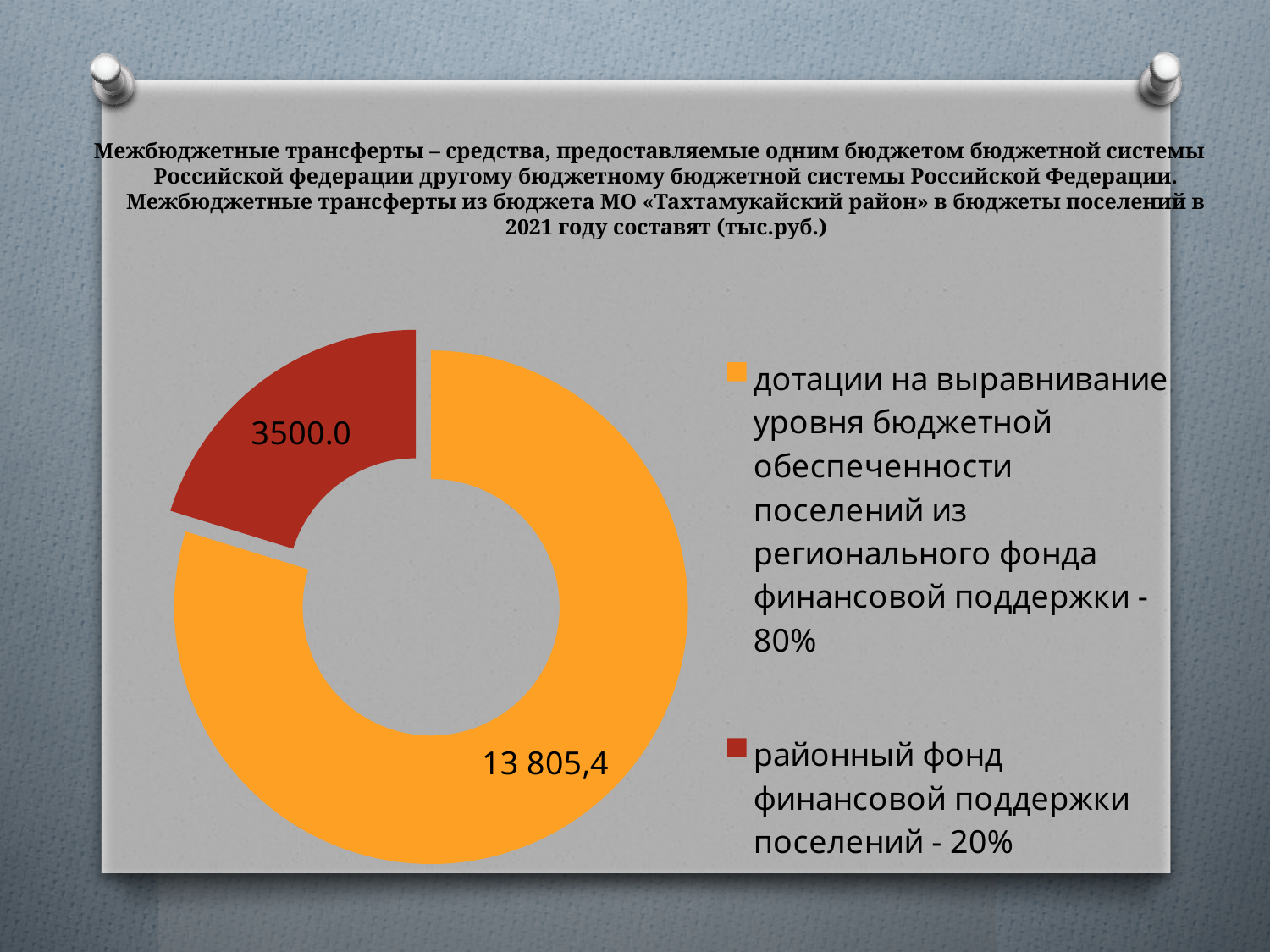
What is the value for 'районный фонд финансовой поддержки поселений'? 3500.0 What colour is the slice for 'дотации на выравнивание уровня бюджетной обеспеченности поселений'? orange What share of the chart does 'районный фонд финансовой поддержки поселений' represent? 20% What share of the chart does 'дотации на выравнивание уровня бюджетной обеспеченности поселений' represent? 80% What is the value for 'дотации на выравнивание уровня бюджетной обеспеченности поселений из регионального фонда финансовой поддержки'? 13 805,4 Which category has the smallest slice of the chart? районный фонд финансовой поддержки поселений What colour is the slice for 'районный фонд финансовой поддержки поселений'? red Which is larger: the value for 'районный фонд финансовой поддержки поселений' or the value for 'дотации на выравнивание уровня бюджетной обеспеченности поселений'? дотации на выравнивание уровня бюджетной обеспеченности поселений Which category has the largest slice of the chart? дотации на выравнивание уровня бюджетной обеспеченности поселений из регионального фонда финансовой поддержки How many slices does the chart have? 2 How many entries does the legend list? 2 What kind of chart is shown on the slide? doughnut (pie) chart